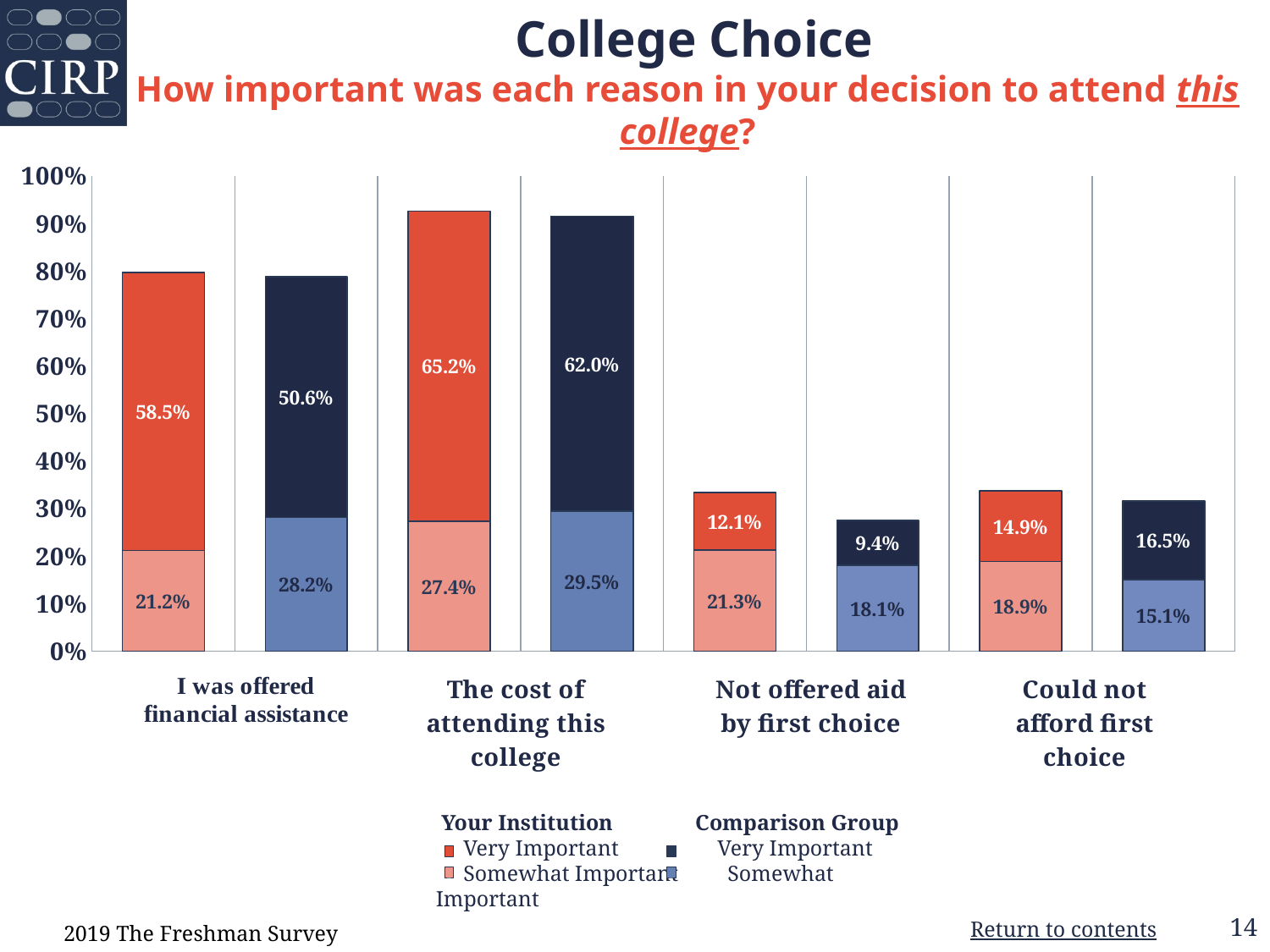
What is the difference between Your Institution and the Comparison Group in the Very Important percentage for "I was offered financial assistance"? 7.9% How many series does the chart legend list? 4 What percentage of Your Institution students rated "The cost of attending this college" as Very Important? 65.2% What percentage of the Comparison Group rated "I was offered financial assistance" as Somewhat Important? 28.2% What percentage of the Comparison Group rated "Not offered aid by first choice" as Very Important? 9.4% Which reason has the lowest Very Important percentage for the Comparison Group? Not offered aid by first choice How many reasons (categories) are shown on the x axis of the chart? 4 What is the combined Very Important and Somewhat Important percentage for Your Institution on "The cost of attending this college"? 92.6% For "Could not afford first choice", which group has the larger Very Important percentage, Your Institution or the Comparison Group? Comparison Group What is the combined Very Important and Somewhat Important percentage for the Comparison Group on "Not offered aid by first choice"? 27.5% What type of chart is shown on the slide? Stacked bar chart Which reason has the highest Very Important percentage for Your Institution? The cost of attending this college